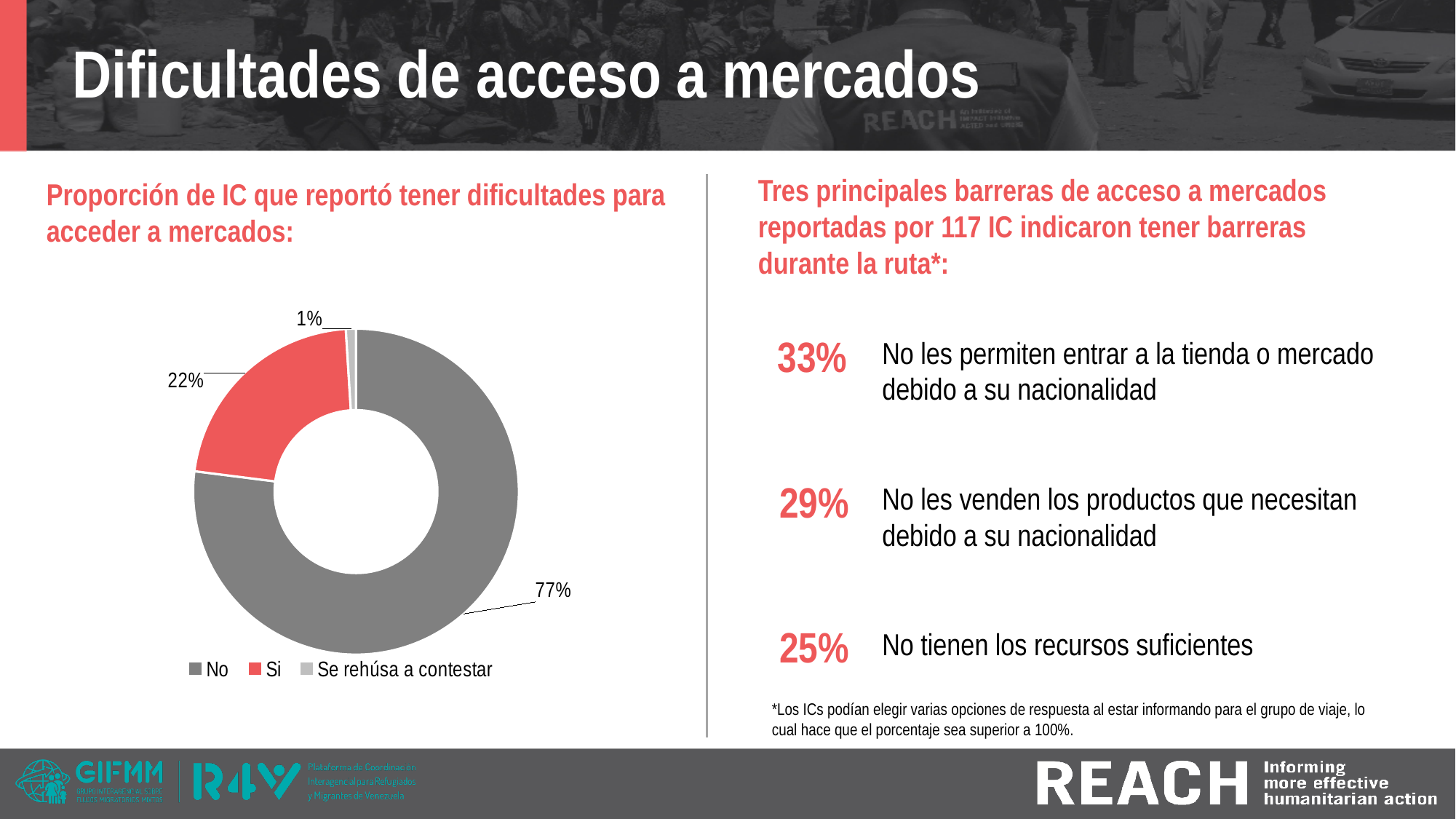
What is the difference in percentage points between the "No" and "Si" slices? 55 What kind of chart is shown on the slide? Pie chart (donut) What colour is the "Si" slice in the pie chart? Red How many categories does the pie chart show? 3 How many entries does the legend of the pie chart list? 3 What percentage of the pie chart corresponds to "No"? 77% Which category has the smallest slice in the pie chart? Se rehúsa a contestar What percentage of the pie chart corresponds to "Se rehúsa a contestar"? 1% What percentage of the pie chart corresponds to "Si"? 22% Which slice is larger, "Si" or "Se rehúsa a contestar"? Si What is the combined share of the "Si" and "Se rehúsa a contestar" slices? 23% Which category has the largest slice in the pie chart? No